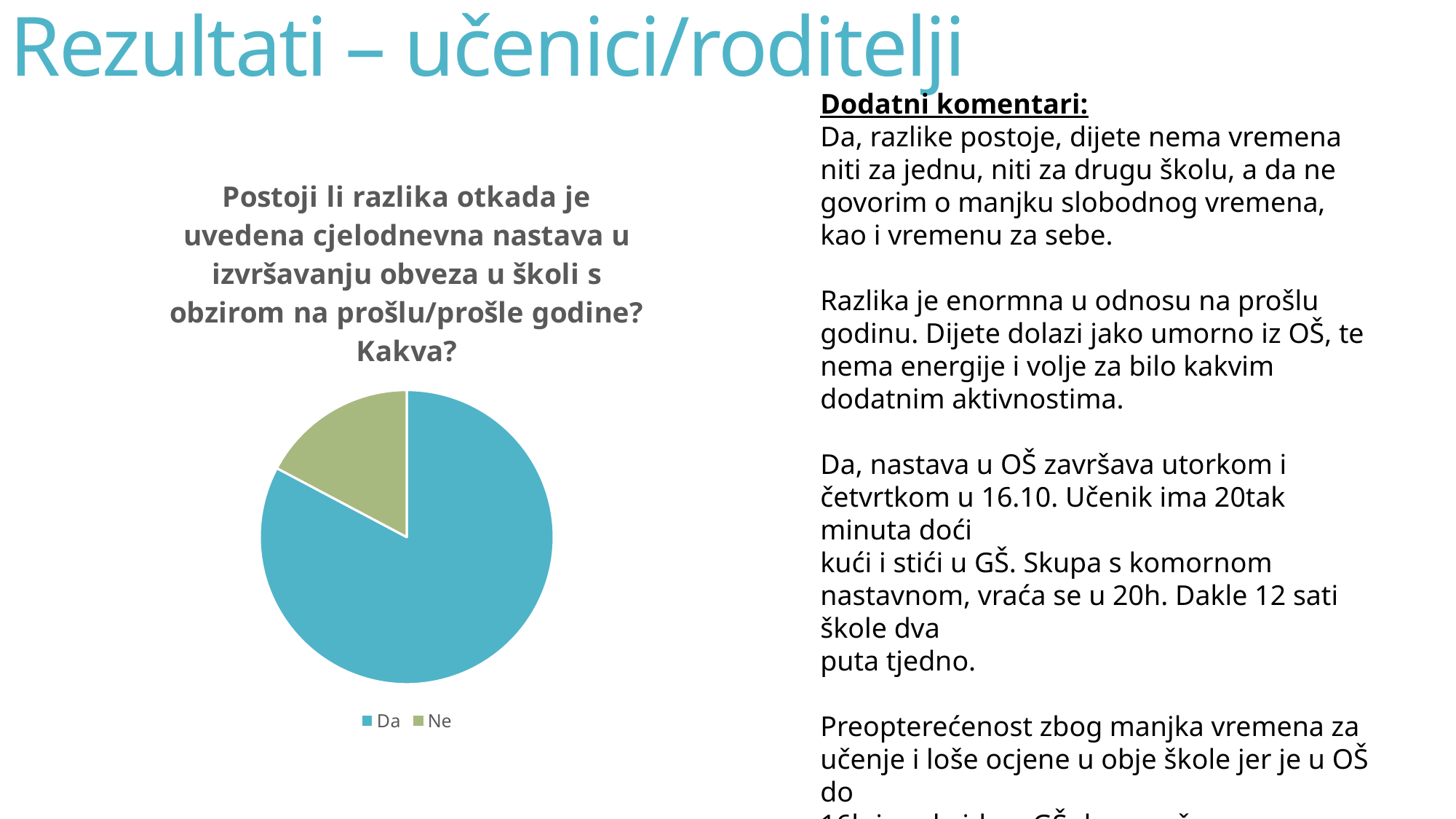
Does the Da slice take up more or less than half of the pie chart? more What kind of chart is shown on the slide? pie chart What are the two legend entries of the pie chart? Da, Ne How many entries does the legend of the pie chart list? 2 What colour is the Ne slice in the pie chart? green Which category has the smallest slice in the pie chart? Ne Which category has the largest slice in the pie chart? Da Which slice is larger in the pie chart, Da or Ne? Da How many slices does the pie chart have? 2